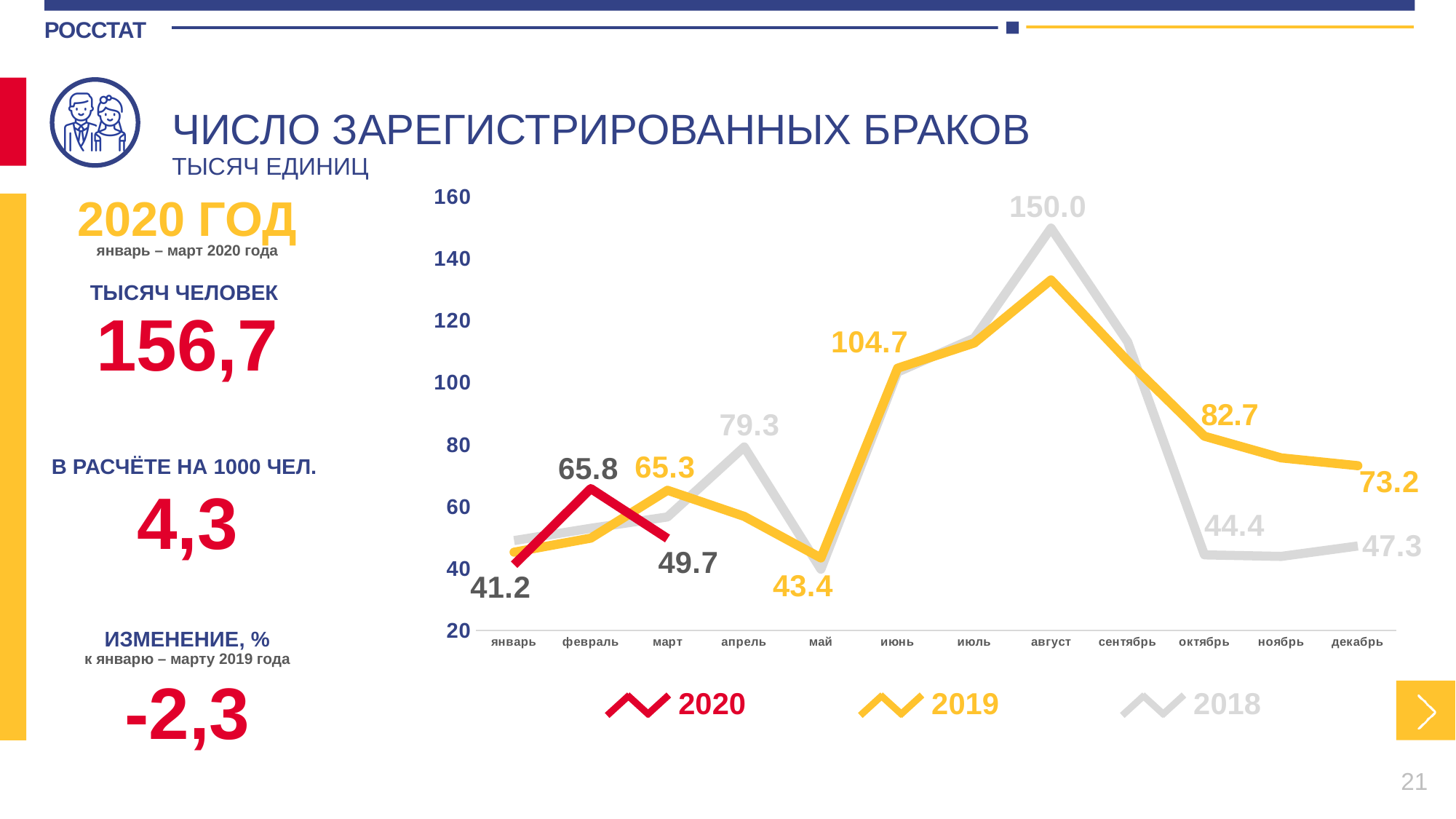
What is the value for 2018 in октябрь? 44.4 What is the difference between the 2019 value for октябрь and the 2018 value for октябрь? 38.3 Is the 2019 value for август greater or less than 120? greater What is the value for 2019 in июнь? 104.7 How many series does the legend list? 3 What is the value for 2020 in февраль? 65.8 Which is larger: the 2020 value for март or the 2019 value for март? 2019 What type of chart is shown? line chart What is the difference between the 2020 values for февраль and март? 16.1 What is the value for 2018 in август? 150.0 What is the value for 2019 in декабрь? 73.2 How many months are shown on the x axis? 12